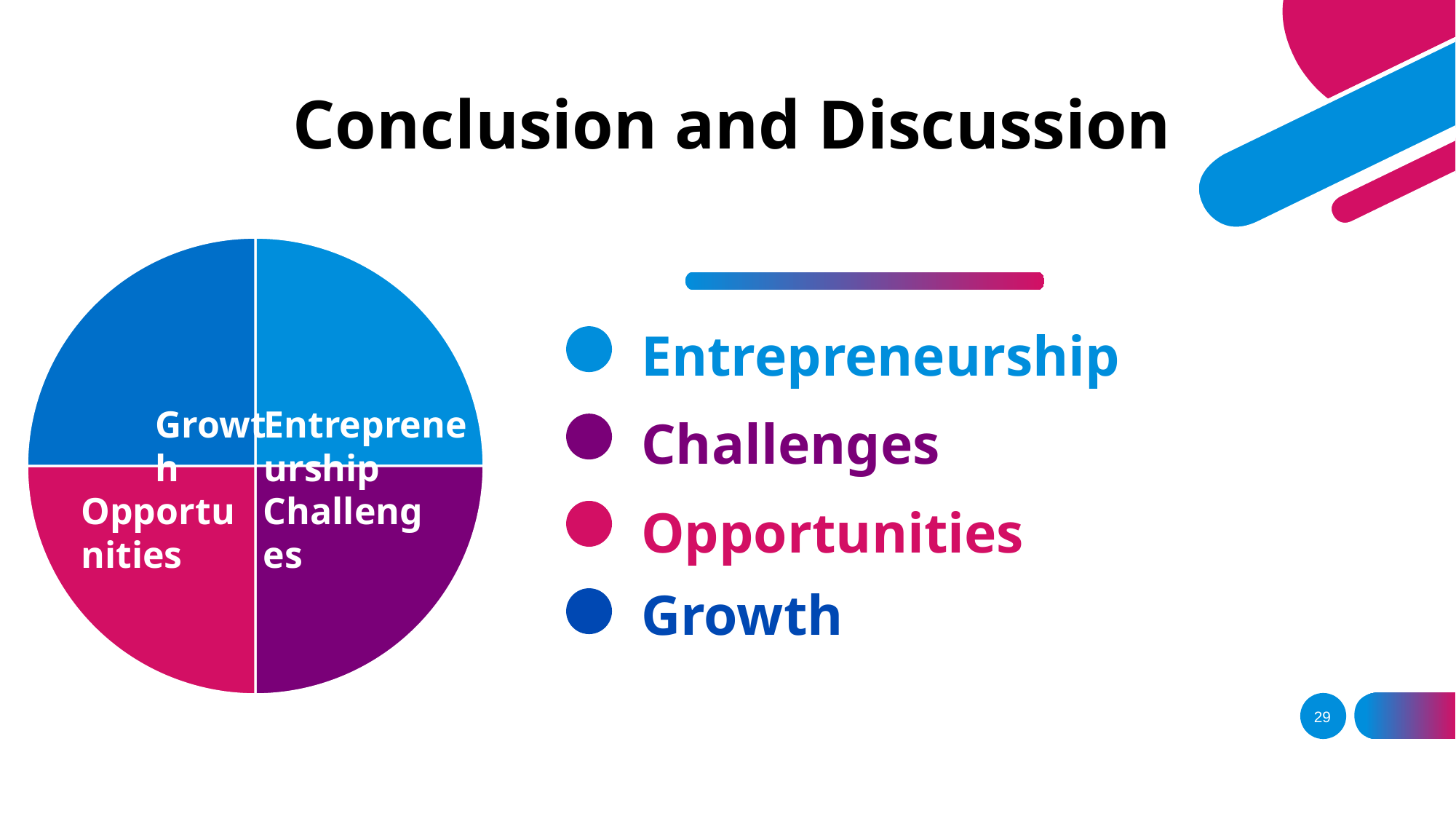
Which category is shown in the bottom-left slice of the pie chart? Opportunities Which slice of the pie chart is coloured light blue? Entrepreneurship Which slice of the pie chart is coloured purple? Challenges What kind of chart is shown on the slide? pie chart Which category is shown in the bottom-right slice of the pie chart? Challenges Which category is shown in the top-left slice of the pie chart? Growth How many categories are listed in the legend next to the pie chart? 4 Which category is shown in the top-right slice of the pie chart? Entrepreneurship How many slices does the pie chart have? 4